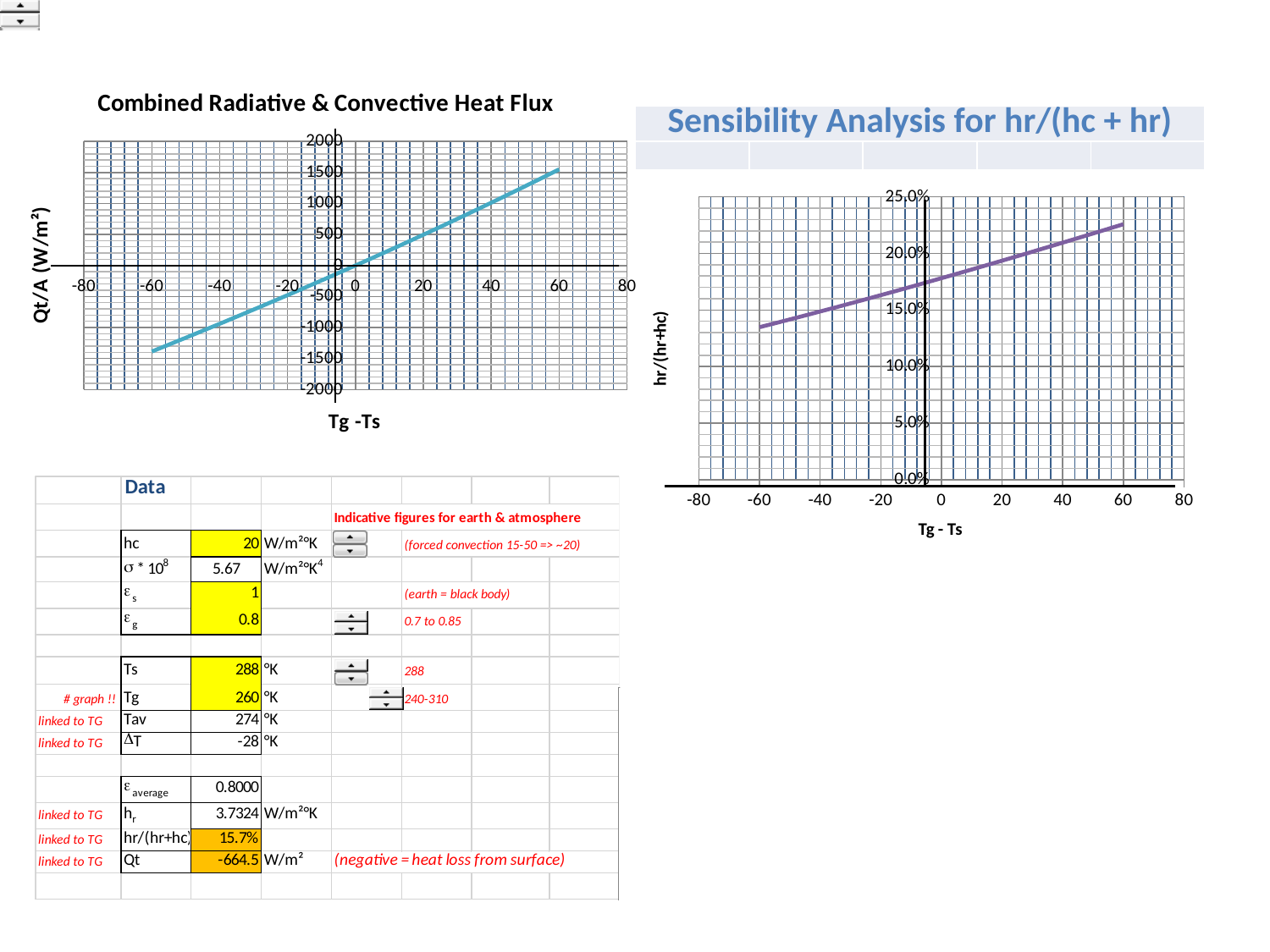
In the "Sensibility Analysis for hr/(hc + hr)" chart, is the value at Tg - Ts = 0 greater or less than 15.0%? greater In the "Combined Radiative & Convective Heat Flux" chart, is the value at Tg -Ts = 40 greater or less than 500? greater What kind of chart is the "Combined Radiative & Convective Heat Flux" chart? line chart In the "Sensibility Analysis for hr/(hc + hr)" chart, does the plotted line rise or fall as Tg - Ts increases? rise In the "Combined Radiative & Convective Heat Flux" chart, does the plotted line rise or fall as Tg -Ts increases? rise What kind of chart is the "Sensibility Analysis for hr/(hc + hr)" chart? line chart In the "Sensibility Analysis for hr/(hc + hr)" chart, is the value at Tg - Ts = 60 greater or less than 20.0%? greater What is the y-axis title of the "Sensibility Analysis for hr/(hc + hr)" chart? hr/(hr+hc) What is the y-axis title of the "Combined Radiative & Convective Heat Flux" chart? Qt/A (W/m²)